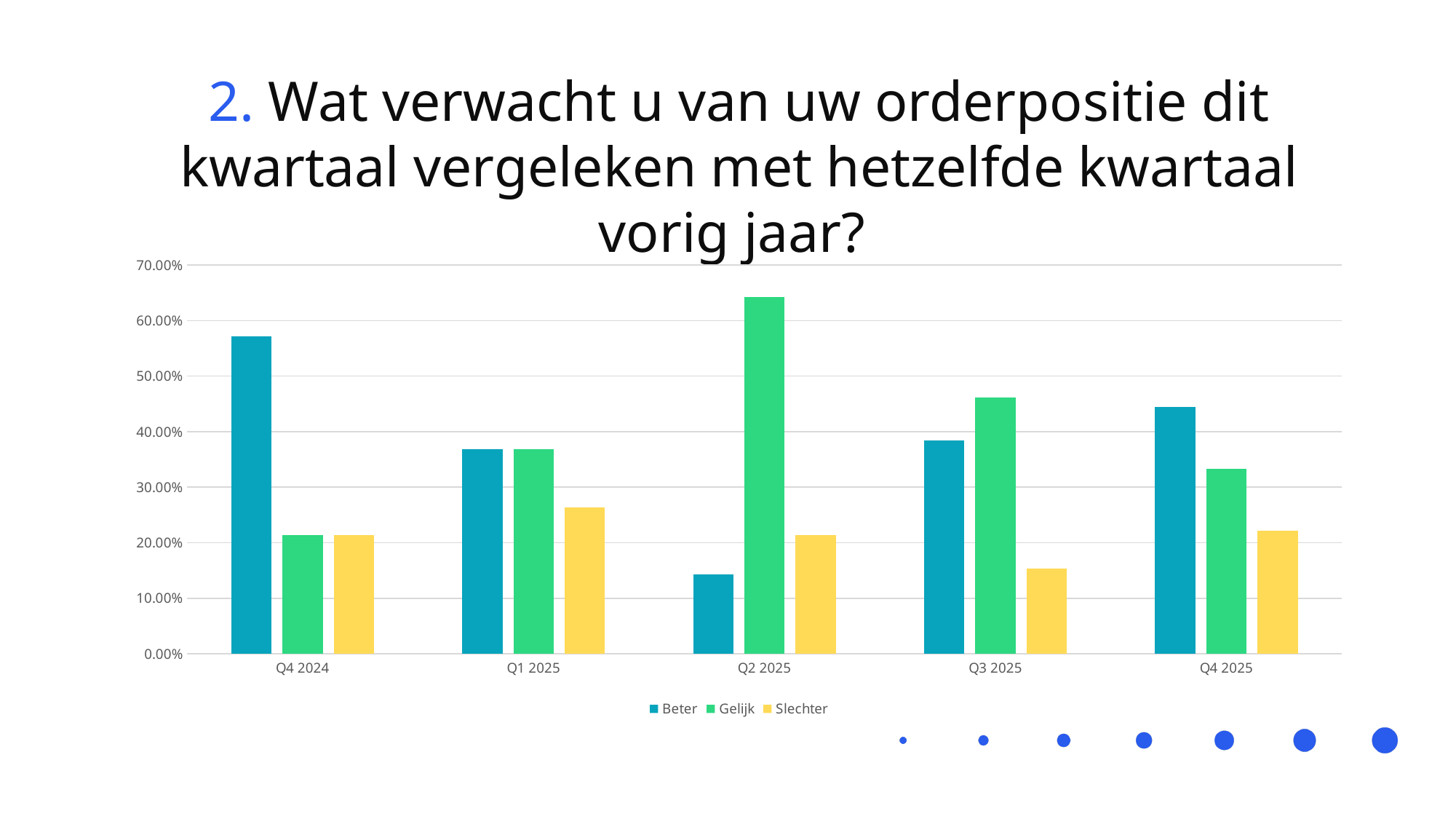
Is the value for Beter in Q4 2024 greater or less than 50.00%? greater In which quarter is the Beter bar the lowest? Q2 2025 What kind of chart is shown on the slide? bar chart What colour represents the Slechter series in the legend? yellow In Q4 2025, which is larger: Beter or Gelijk? Beter In which quarter is the Beter bar the highest? Q4 2024 How many series does the legend list? 3 In which quarter is the Slechter bar the lowest? Q3 2025 Is the value for Gelijk in Q2 2025 greater or less than 60.00%? greater In which quarter is the Gelijk bar the highest? Q2 2025 In Q3 2025, which is larger: Beter or Gelijk? Gelijk How many quarters are shown on the x axis? 5